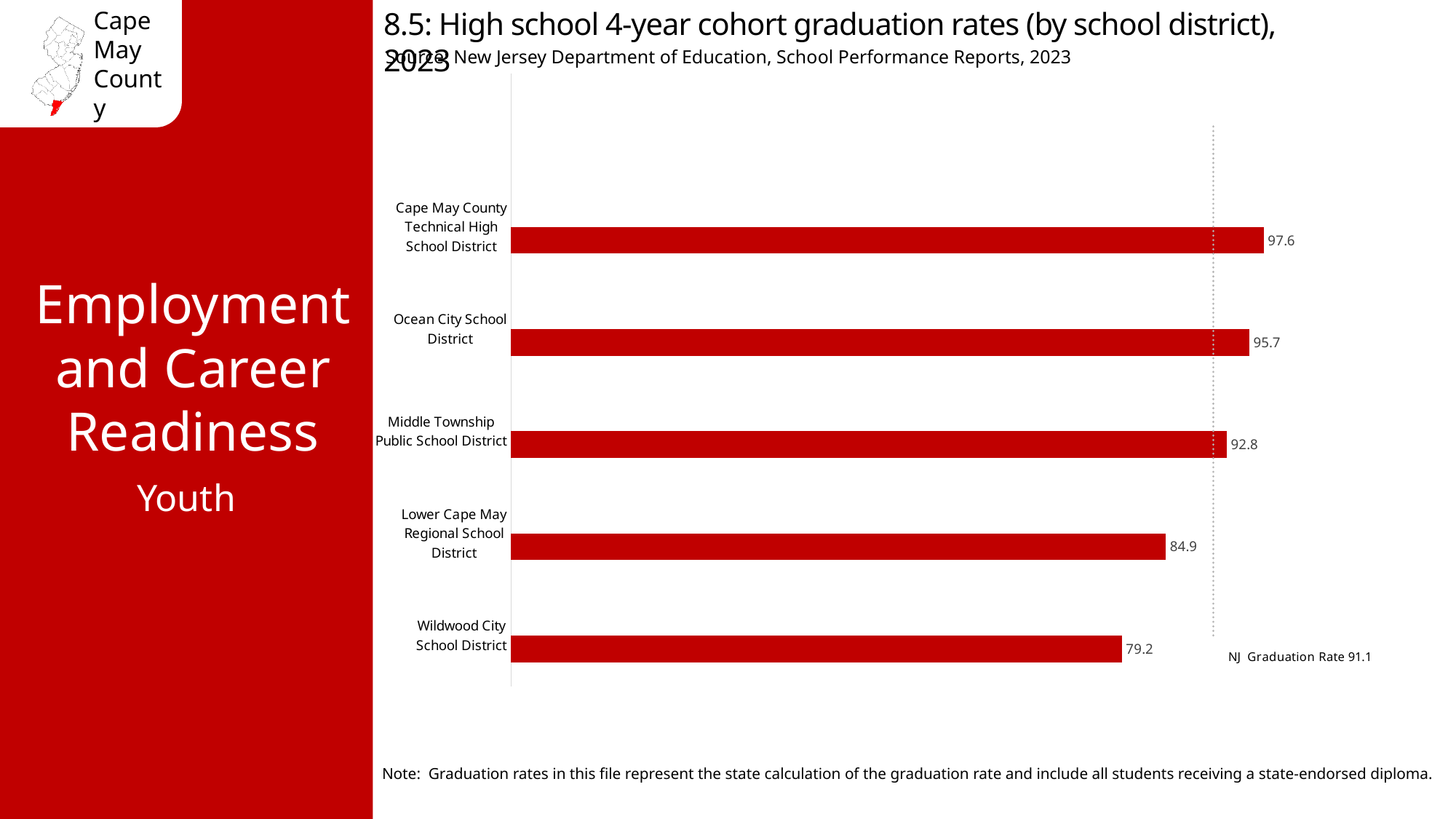
What is the difference between the graduation rates of Ocean City School District and Lower Cape May Regional School District? 10.8 What is the graduation rate for Middle Township Public School District? 92.8 How many school districts have a graduation rate below the NJ graduation rate of 91.1? 2 What is the graduation rate for Cape May County Technical High School District? 97.6 What kind of chart is shown on the slide? Bar chart What NJ graduation rate is marked by the dotted reference line? 91.1 What is the graduation rate for Wildwood City School District? 79.2 Which school district has the highest graduation rate? Cape May County Technical High School District Which has a higher graduation rate, Ocean City School District or Middle Township Public School District? Ocean City School District What is the difference between the highest and lowest graduation rates shown? 18.4 How many school districts are shown in the chart? 5 Which school district has the lowest graduation rate? Wildwood City School District